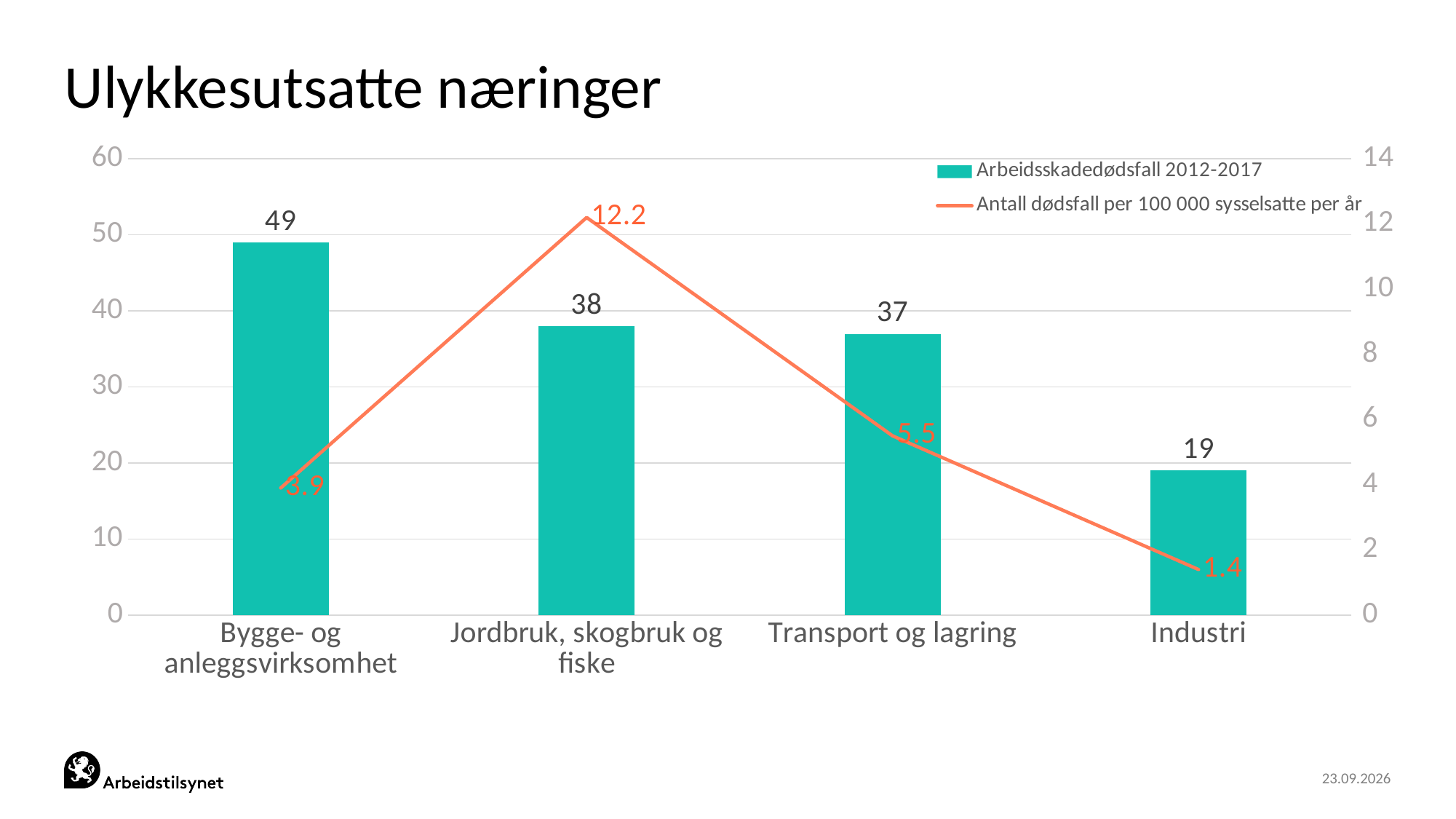
What is the difference in Arbeidsskadedødsfall 2012-2017 between Bygge- og anleggsvirksomhet and Industri? 30 Which category has the lowest value for Antall dødsfall per 100 000 sysselsatte per år? Industri What is the value of Antall dødsfall per 100 000 sysselsatte per år for Jordbruk, skogbruk og fiske? 12.2 What is the value of Arbeidsskadedødsfall 2012-2017 for Industri? 19 Which has a higher value for Antall dødsfall per 100 000 sysselsatte per år: Bygge- og anleggsvirksomhet or Transport og lagring? Transport og lagring What is the value of Antall dødsfall per 100 000 sysselsatte per år for Transport og lagring? 5.5 What is the title of the slide? Ulykkesutsatte næringer How many series does the legend list? 2 Which category has the highest value for Arbeidsskadedødsfall 2012-2017? Bygge- og anleggsvirksomhet How many categories are shown on the x axis? 4 What is the value of Arbeidsskadedødsfall 2012-2017 for Bygge- og anleggsvirksomhet? 49 What kind of chart is shown on the slide? Combined bar and line chart